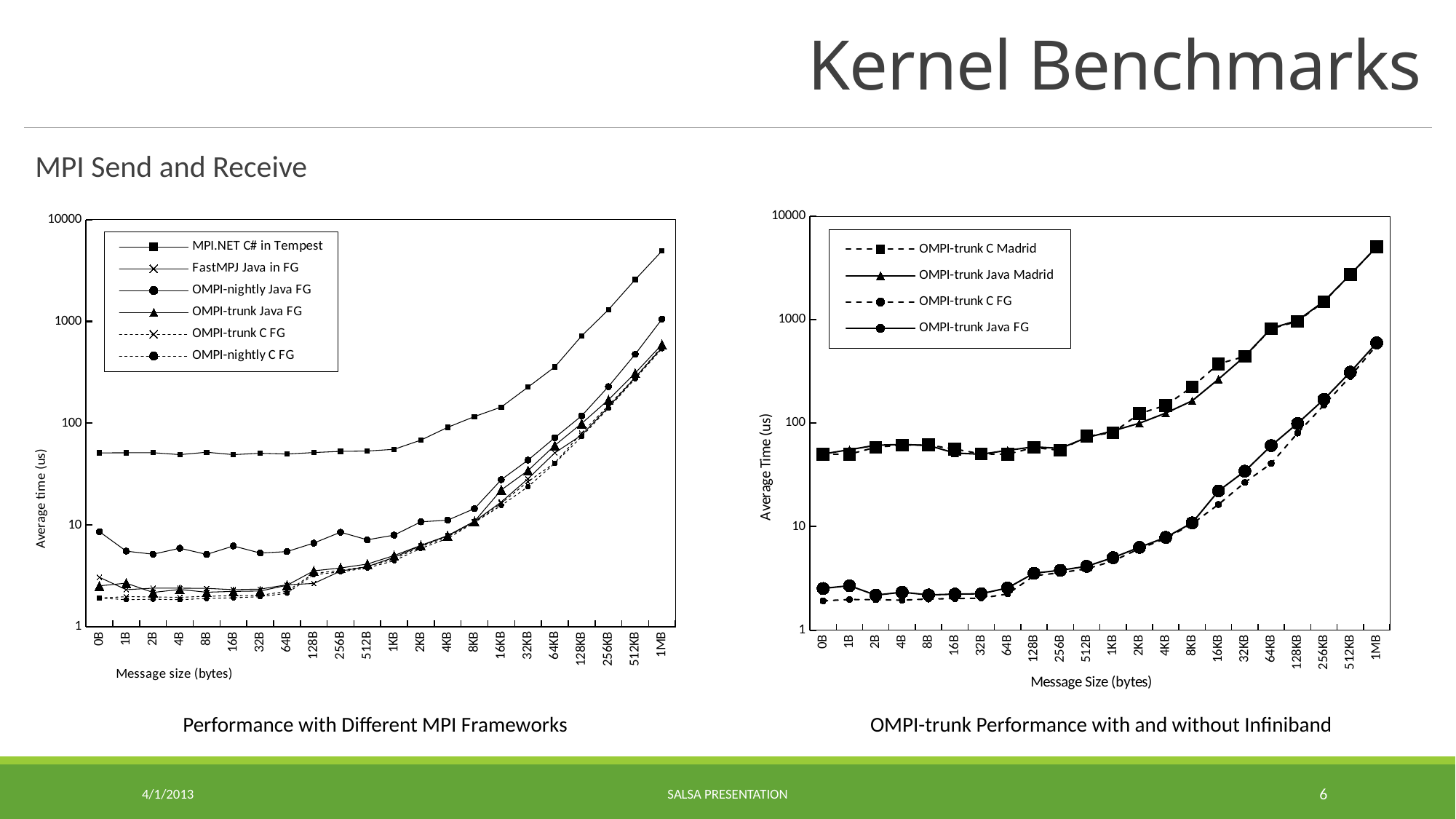
How many series does the legend of the left chart, 'Performance with Different MPI Frameworks', list? 6 In the left chart, 'Performance with Different MPI Frameworks', is the value for OMPI-trunk Java FG at 0B greater or less than 10? less In the left chart, 'Performance with Different MPI Frameworks', is the value for MPI.NET C# in Tempest at 1MB greater or less than 1000? greater How many series does the legend of the right chart, 'OMPI-trunk Performance with and without Infiniband', list? 4 What kind of chart is the left chart, 'Performance with Different MPI Frameworks'? line chart In the left chart, 'Performance with Different MPI Frameworks', which series has the highest average time at 1MB? MPI.NET C# in Tempest How many message size categories are shown on the x axis of the right chart, 'OMPI-trunk Performance with and without Infiniband'? 22 In the right chart, 'OMPI-trunk Performance with and without Infiniband', do the values for OMPI-trunk Java FG rise or fall from 1KB to 1MB? rise What is the y-axis title of the right chart, 'OMPI-trunk Performance with and without Infiniband'? Average Time (us) What is the x-axis title of the left chart, 'Performance with Different MPI Frameworks'? Message size (bytes) In the right chart, 'OMPI-trunk Performance with and without Infiniband', which is larger at 1MB: OMPI-trunk C Madrid or OMPI-trunk C FG? OMPI-trunk C Madrid In the right chart, 'OMPI-trunk Performance with and without Infiniband', is the value for OMPI-trunk C Madrid at 0B greater or less than 10? greater